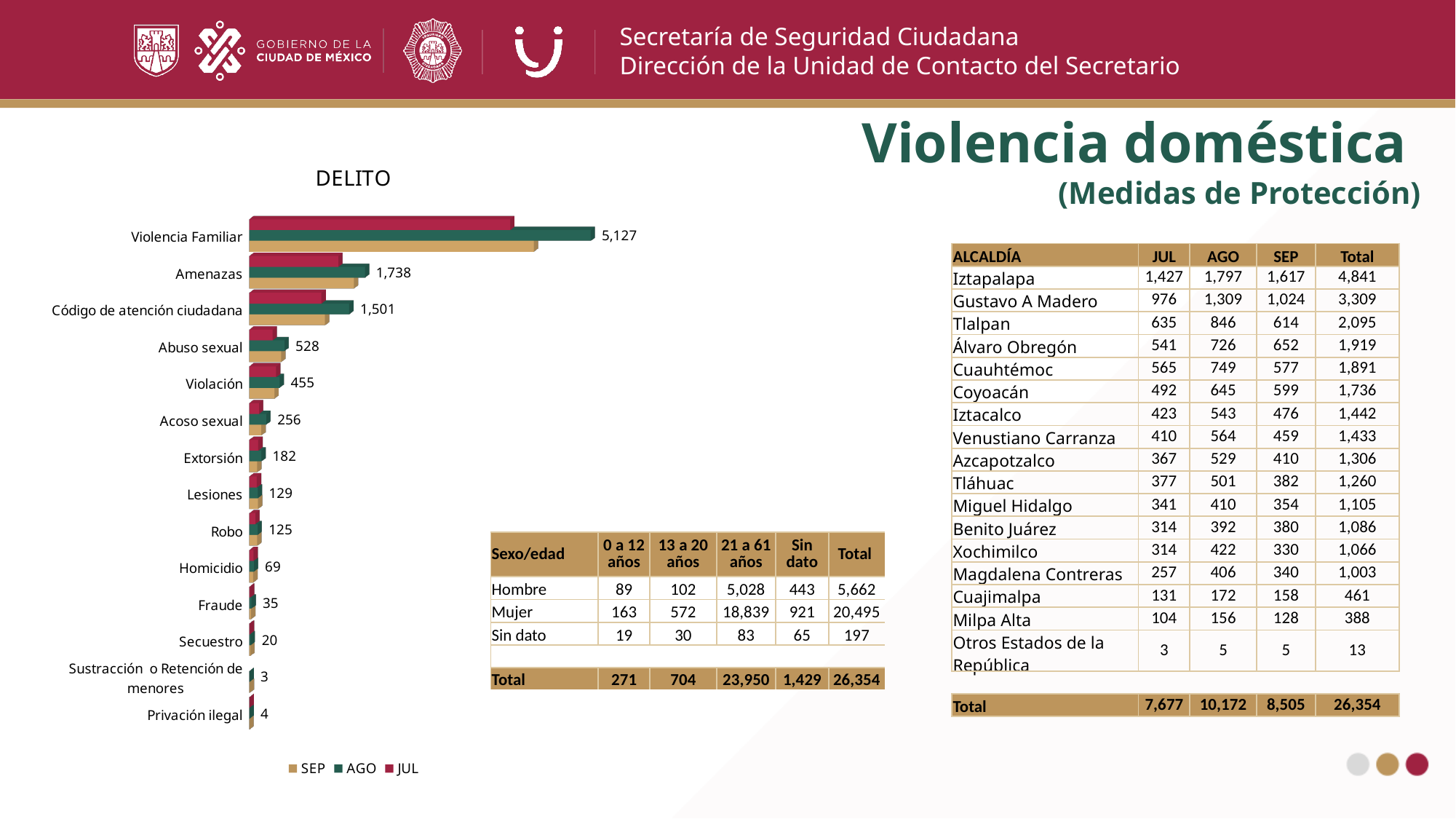
What is the AGO value for Amenazas on the DELITO chart? 1,738 How many series does the legend of the DELITO chart list? 3 What is the AGO value for Violencia Familiar on the DELITO chart? 5,127 On the DELITO chart, what is the difference between the AGO values for Amenazas and Código de atención ciudadana? 237 Which category has the lowest AGO value on the DELITO chart? Sustracción o Retención de menores On the DELITO chart, for Violencia Familiar, which bar is longer, AGO or JUL? AGO How many delito categories are shown on the DELITO chart? 14 What is the AGO value for Abuso sexual on the DELITO chart? 528 Which category has the highest AGO value on the DELITO chart? Violencia Familiar On the DELITO chart, which has the larger AGO value, Lesiones or Robo? Lesiones What are the legend entries of the DELITO chart? SEP, AGO, JUL What kind of chart is the DELITO chart? bar chart